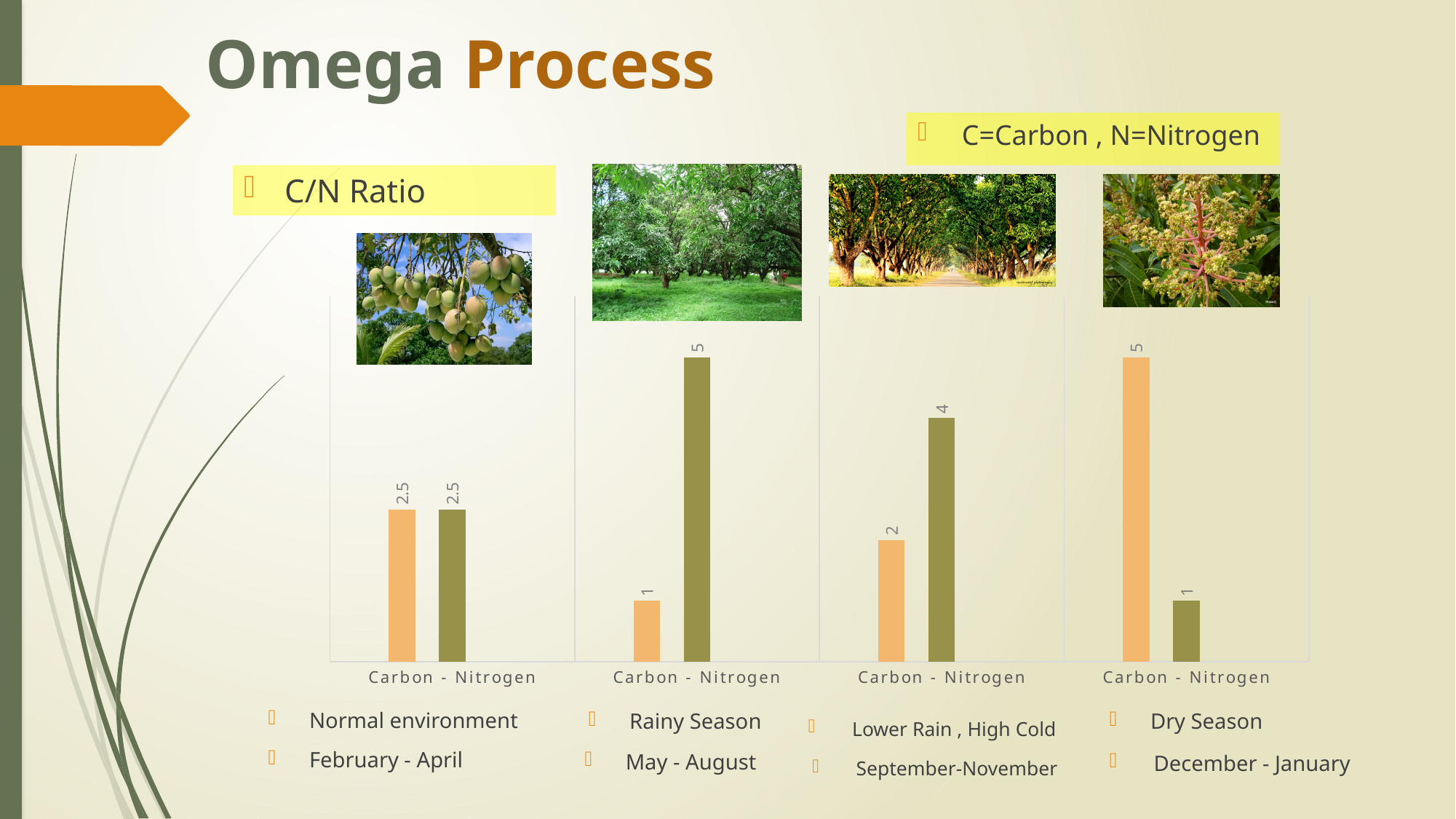
In the Normal environment chart, are the two bars equal in value? Yes In the Lower Rain, High Cold chart (September-November), what is the value of the orange bar? 2 What x-axis label appears beneath each of the four charts? Carbon - Nitrogen In the leftmost chart (Normal environment, February - April), what is the value of the orange bar? 2.5 In the Rainy Season chart, what is the difference between the olive bar and the orange bar? 4 In the Dry Season chart (December - January), what is the value of the olive bar? 1 In the Rainy Season chart (May - August), what is the value of the olive bar? 5 How many bars are plotted in the Dry Season chart? 2 What kind of chart is used for the C/N Ratio data on this slide? bar chart In the Rainy Season chart, which bar has the highest value? the olive bar In the Dry Season chart, which bar is taller, the orange bar or the olive bar? orange In the Lower Rain, High Cold chart, what is the difference between the olive bar and the orange bar? 2